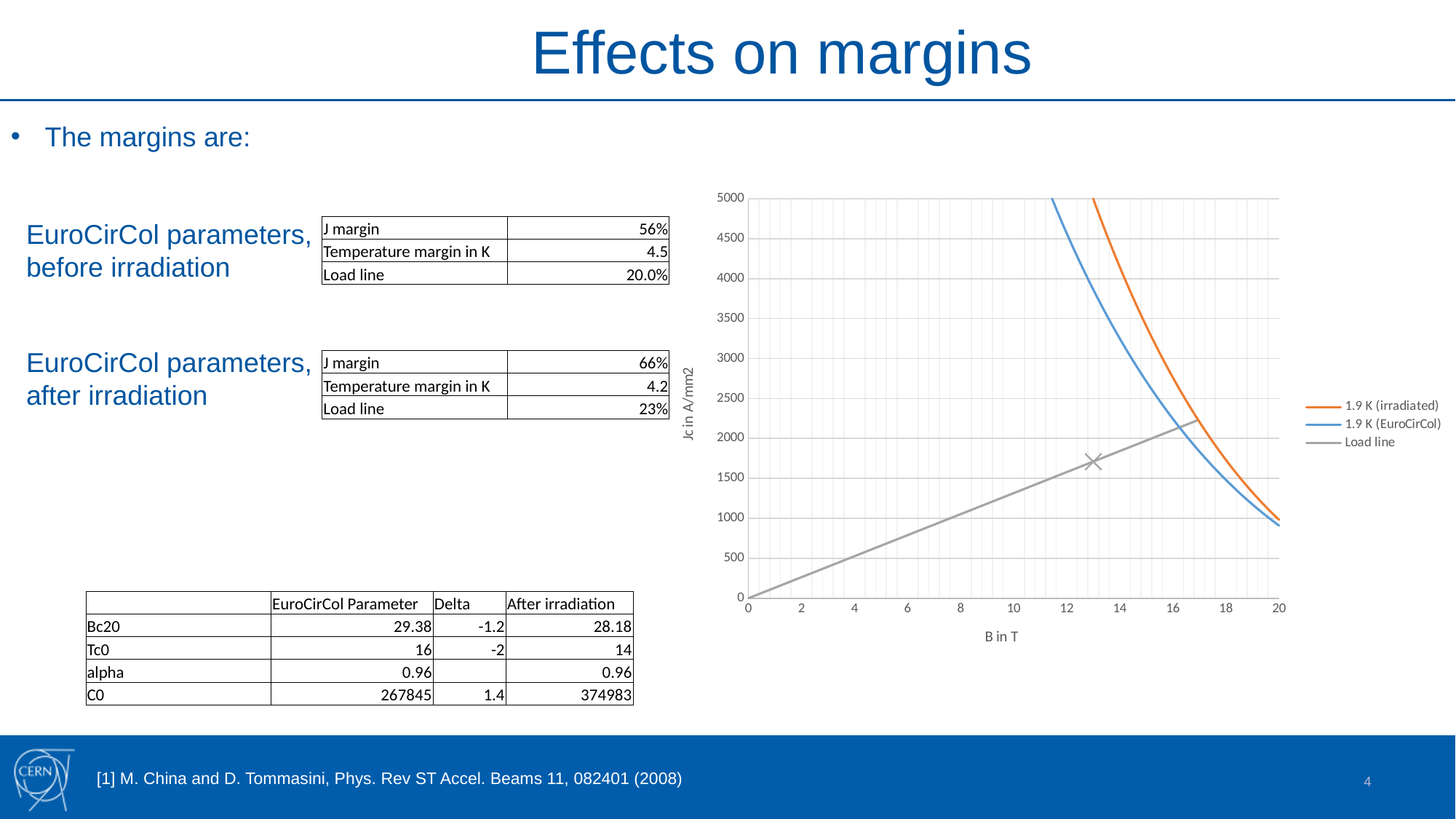
What kind of chart is shown on the slide? line chart What is the title of the x axis of the chart? B in T Is the value of the Load line series at B = 4 T greater or less than 1000? less At B = 16 T, which series has the higher Jc value: 1.9 K (irradiated) or 1.9 K (EuroCirCol)? 1.9 K (irradiated) At B = 18 T, which series has the lower Jc value: 1.9 K (irradiated) or 1.9 K (EuroCirCol)? 1.9 K (EuroCirCol) Is the value of the Load line series at B = 10 T greater or less than 1000? greater What is the title of the y axis of the chart? Jc in A/mm2 Is the value of the 1.9 K (EuroCirCol) series at B = 18 T greater or less than 2500? less How many series does the chart legend list? 3 Does the Load line series rise or fall as B increases? rise Does the 1.9 K (irradiated) series rise or fall as B increases? fall